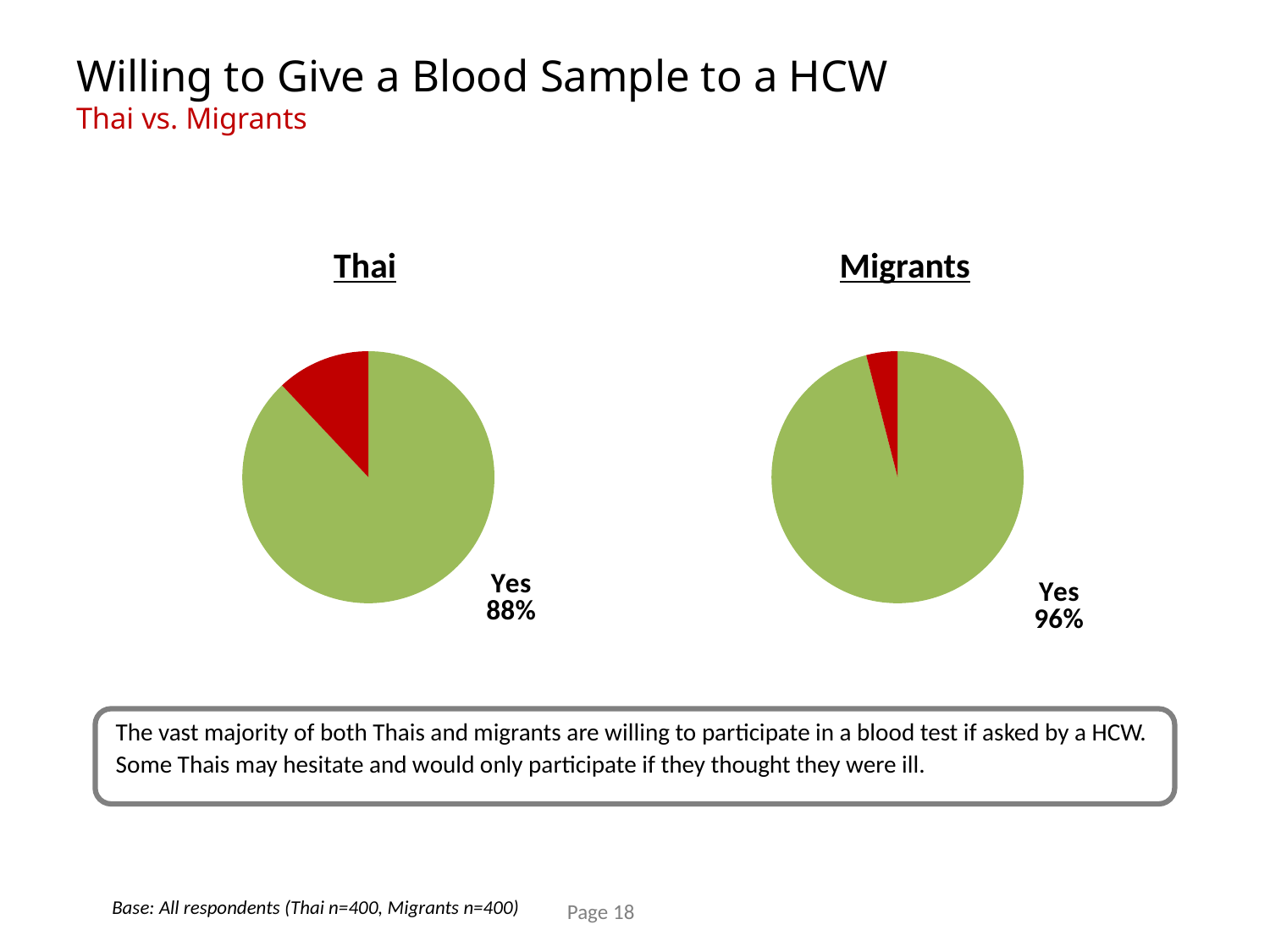
In the Thai pie chart, what percentage of respondents answered Yes? 88% How many slices does the Thai pie chart have? 2 Which group has the larger Yes share, Thai or Migrants? Migrants In the Migrants pie chart, which slice is larger, the green slice or the red slice? The green slice In the Migrants pie chart, what percentage of respondents answered Yes? 96% How many slices does the Migrants pie chart have? 2 What is the difference in percentage points between the Migrants Yes share (96%) and the Thai Yes share (88%)? 8 percentage points What kind of chart is used for the Thai group? Pie chart What kind of chart is used for the Migrants group? Pie chart What colour is the Yes slice in the Thai pie chart? Green In the Thai pie chart, is the Yes share greater or less than 50%? greater What is the title of the slide containing the two pie charts? Willing to Give a Blood Sample to a HCW